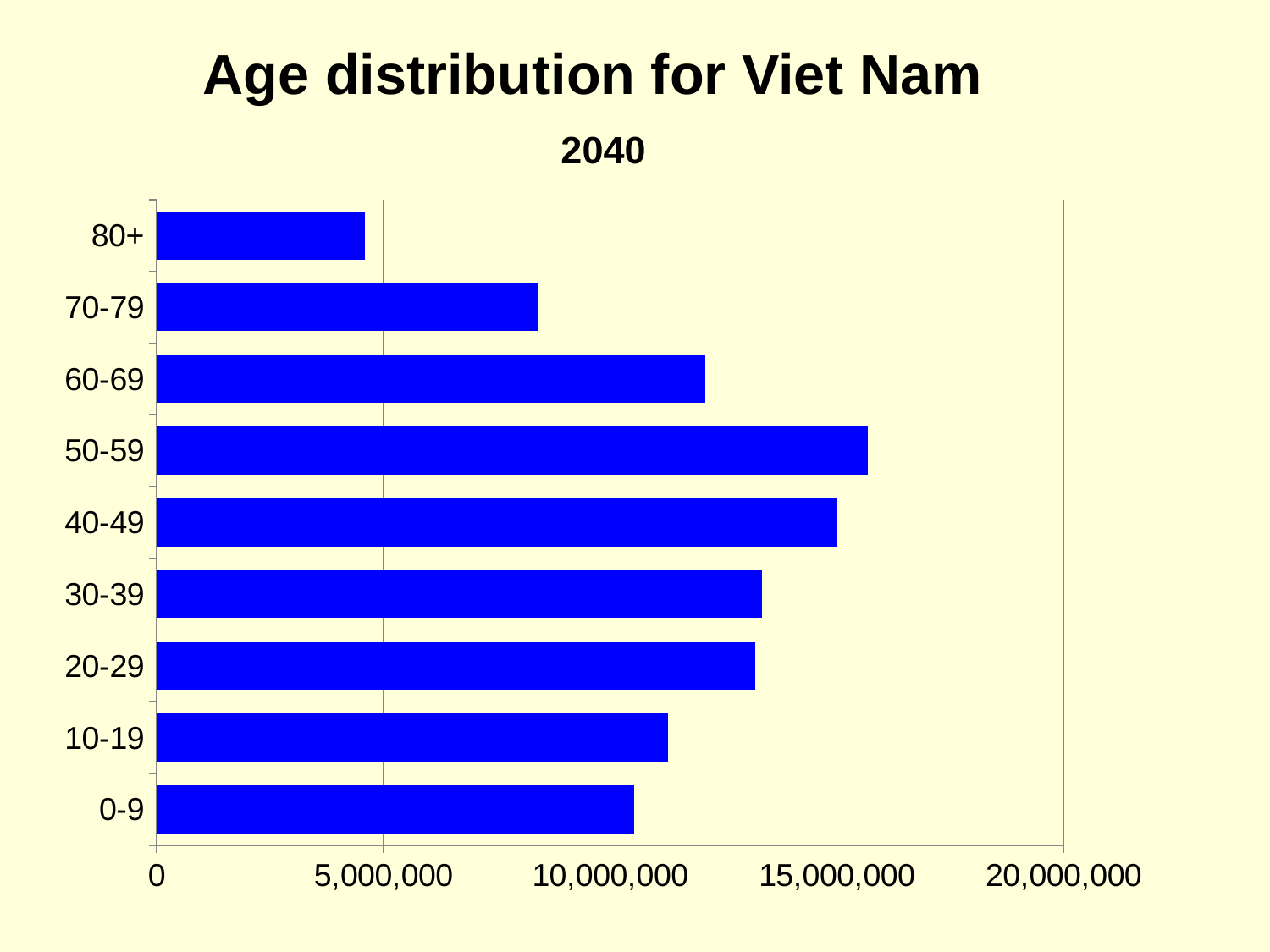
How many age groups are plotted on the chart? 9 Which age group has a larger population, 10-19 or 0-9? 10-19 Which year does the chart show the age distribution for? 2040 Which age group has the smallest population? 80+ Which age group has a larger population, 60-69 or 70-79? 60-69 Is the value for the 70-79 age group greater or less than 10,000,000? less Is the value for the 60-69 age group greater or less than 10,000,000? greater Which age group has the largest population? 50-59 What kind of chart is shown on the slide? bar chart Is the value for the 80+ age group greater or less than 5,000,000? less What is the title of the chart? 2040